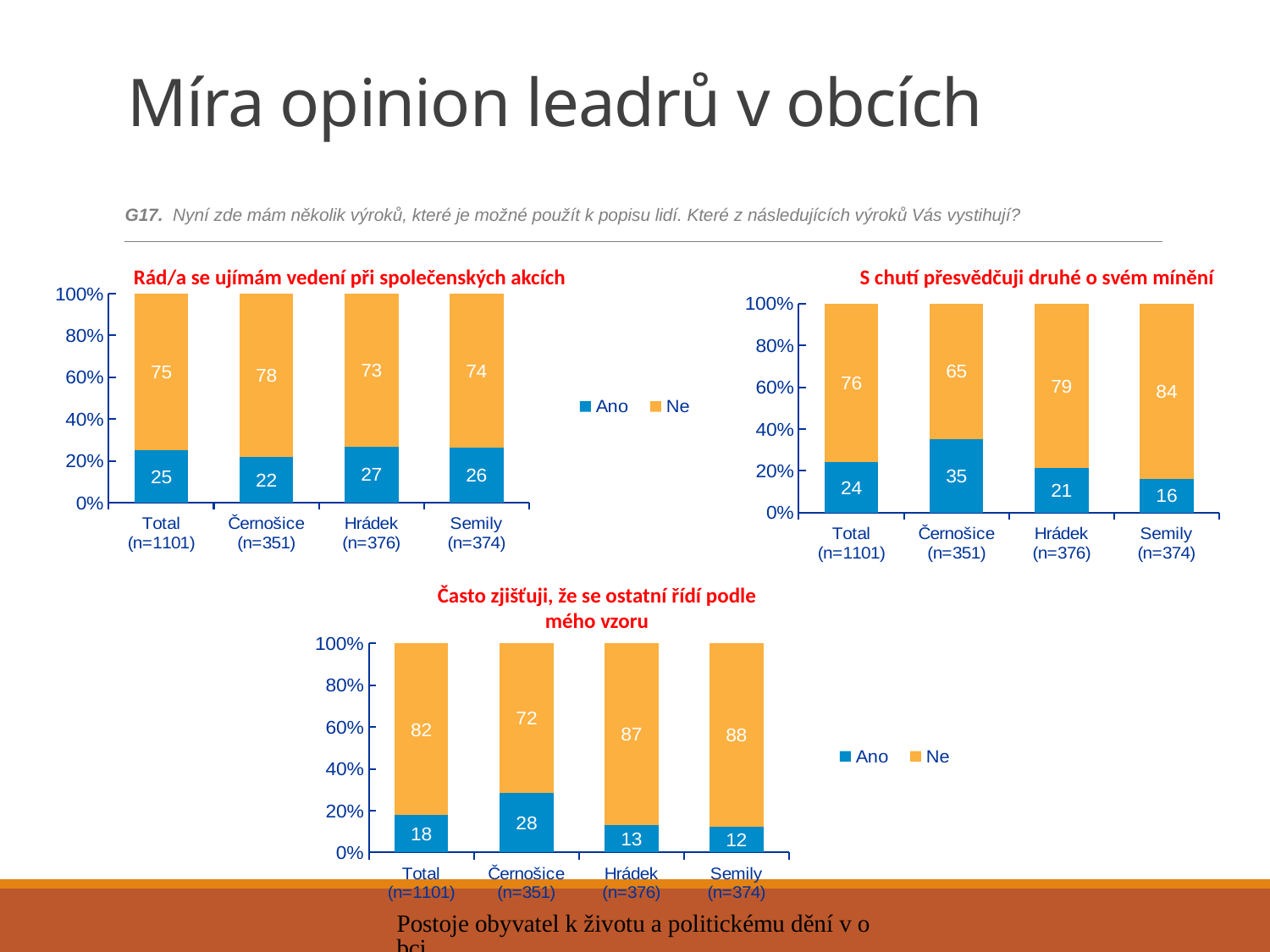
What kind of chart is the chart titled 'S chutí přesvědčuji druhé o svém mínění'? Stacked bar chart In the chart titled 'Často zjišťuji, že se ostatní řídí podle mého vzoru', what is the 'Ano' value for Černošice (n=351)? 28 In the chart titled 'Rád/a se ujímám vedení při společenských akcích', what is the difference between the 'Ne' values for Černošice (n=351) and Hrádek (n=376)? 5 In the chart titled 'Rád/a se ujímám vedení při společenských akcích', which colour represents the 'Ne' series? Orange In the chart titled 'Často zjišťuji, že se ostatní řídí podle mého vzoru', which category has the lowest 'Ano' value? Semily (n=374) In the chart titled 'S chutí přesvědčuji druhé o svém mínění', is the 'Ano' value larger for Total (n=1101) or for Hrádek (n=376)? Total (n=1101) In the chart titled 'Často zjišťuji, že se ostatní řídí podle mého vzoru', what is the difference between the 'Ne' values for Semily (n=374) and Černošice (n=351)? 16 In the chart titled 'S chutí přesvědčuji druhé o svém mínění', which category has the highest 'Ano' value? Černošice (n=351) How many categories are shown on the x axis of the chart titled 'Rád/a se ujímám vedení při společenských akcích'? 4 In the chart titled 'Rád/a se ujímám vedení při společenských akcích', what is the 'Ano' value for Hrádek (n=376)? 27 How many series does the legend of the chart titled 'Často zjišťuji, že se ostatní řídí podle mého vzoru' list? 2 In the chart titled 'S chutí přesvědčuji druhé o svém mínění', what is the 'Ne' value for Semily (n=374)? 84